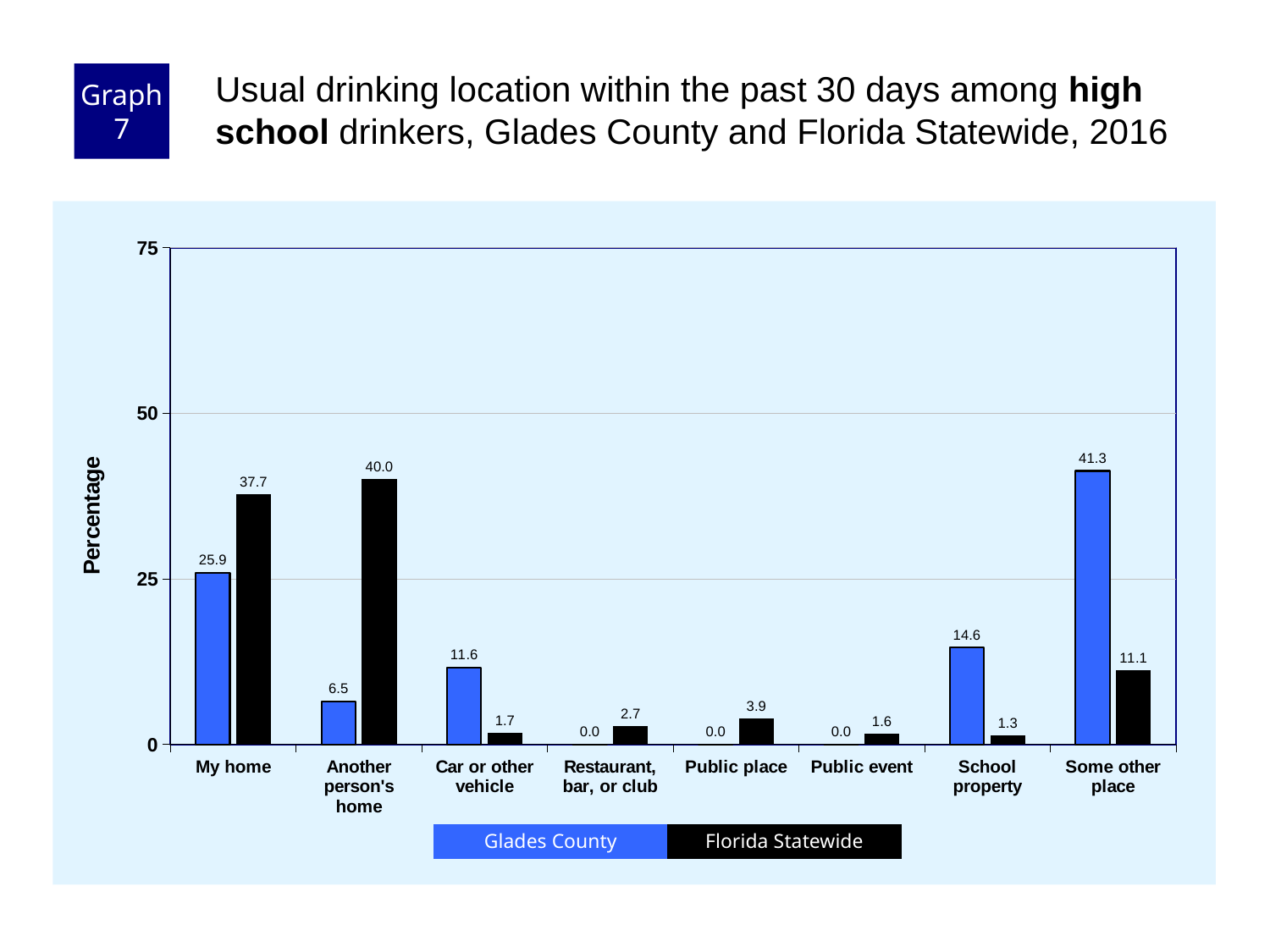
Which category has the lowest Florida Statewide value? School property Which category has the highest Florida Statewide value? Another person's home What is the Glades County value for 'My home'? 25.9 Is the Florida Statewide value for 'My home' greater or less than 25? greater What is the Glades County value for 'School property'? 14.6 Which is larger for 'Some other place': Glades County or Florida Statewide? Glades County What is the difference between the Florida Statewide and Glades County values for 'My home'? 11.8 What is the Florida Statewide value for 'Another person's home'? 40.0 Which category has the highest Glades County value? Some other place How many location categories are shown on the x axis? 8 How many series does the legend list? 2 What kind of chart is shown? Bar chart